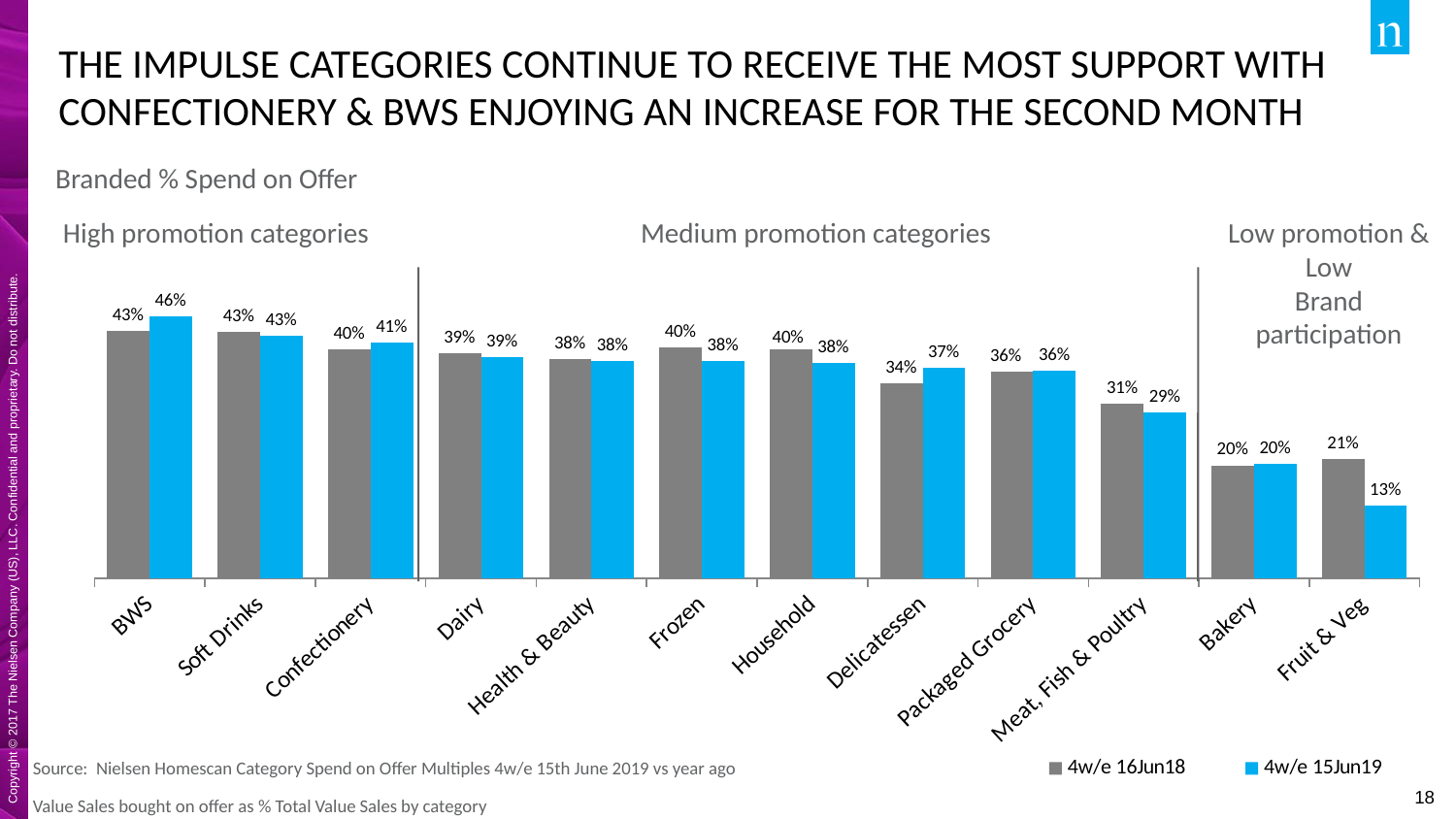
What is the value for Delicatessen in the 4w/e 16Jun18 series? 34% Which colour represents the 4w/e 15Jun19 series in the chart? Blue What is the difference between the 4w/e 16Jun18 and 4w/e 15Jun19 values for Delicatessen? 3% How many series does the legend list? 2 What kind of chart is shown on the slide? Bar chart Which category has the highest value in the 4w/e 15Jun19 series? BWS What is the difference between the 4w/e 16Jun18 and 4w/e 15Jun19 values for Fruit & Veg? 8% Which is larger for Meat, Fish & Poultry: the 4w/e 16Jun18 value or the 4w/e 15Jun19 value? 4w/e 16Jun18 Which category has the lowest value in the 4w/e 15Jun19 series? Fruit & Veg What is the value for BWS in the 4w/e 15Jun19 series? 46% How many categories are shown on the x axis of the chart? 12 What is the value for Fruit & Veg in the 4w/e 15Jun19 series? 13%